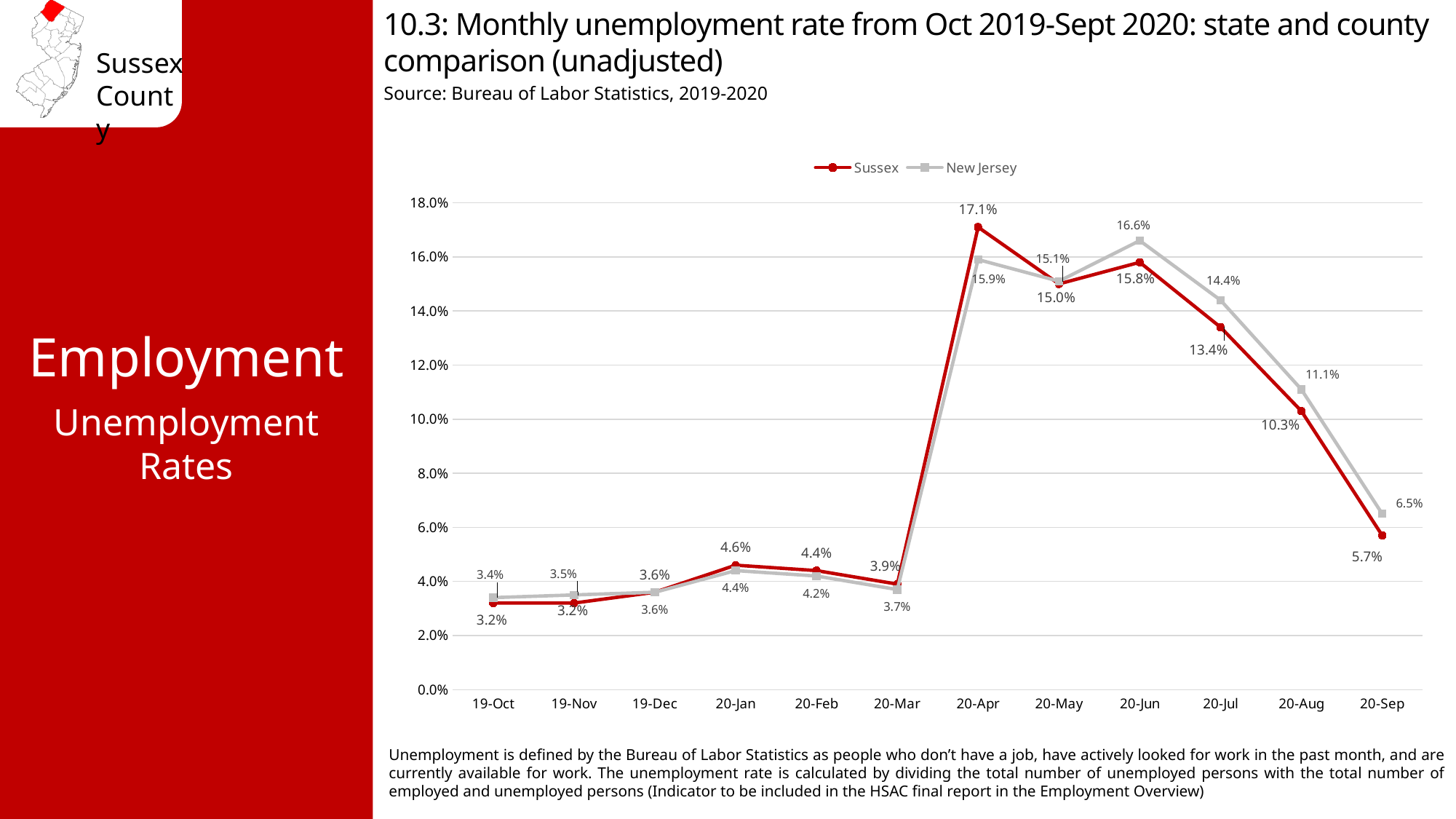
How many series does the legend list? 2 Which series is drawn in red? Sussex In which month did the New Jersey series reach its highest value? 20-Jun How many months are plotted along the x axis? 12 Did the Sussex unemployment rate rise or fall from 20-Jun to 20-Sep? fall Which series had the higher unemployment rate in 20-Jul, Sussex or New Jersey? New Jersey What was the Sussex unemployment rate in 20-Sep? 5.7% What was the Sussex unemployment rate in 20-Apr? 17.1% What was the New Jersey unemployment rate in 20-Jun? 16.6% What is the difference between the Sussex and New Jersey rates in 20-Apr? 1.2% What type of chart is shown on the slide? line chart In which month did the Sussex series reach its highest value? 20-Apr